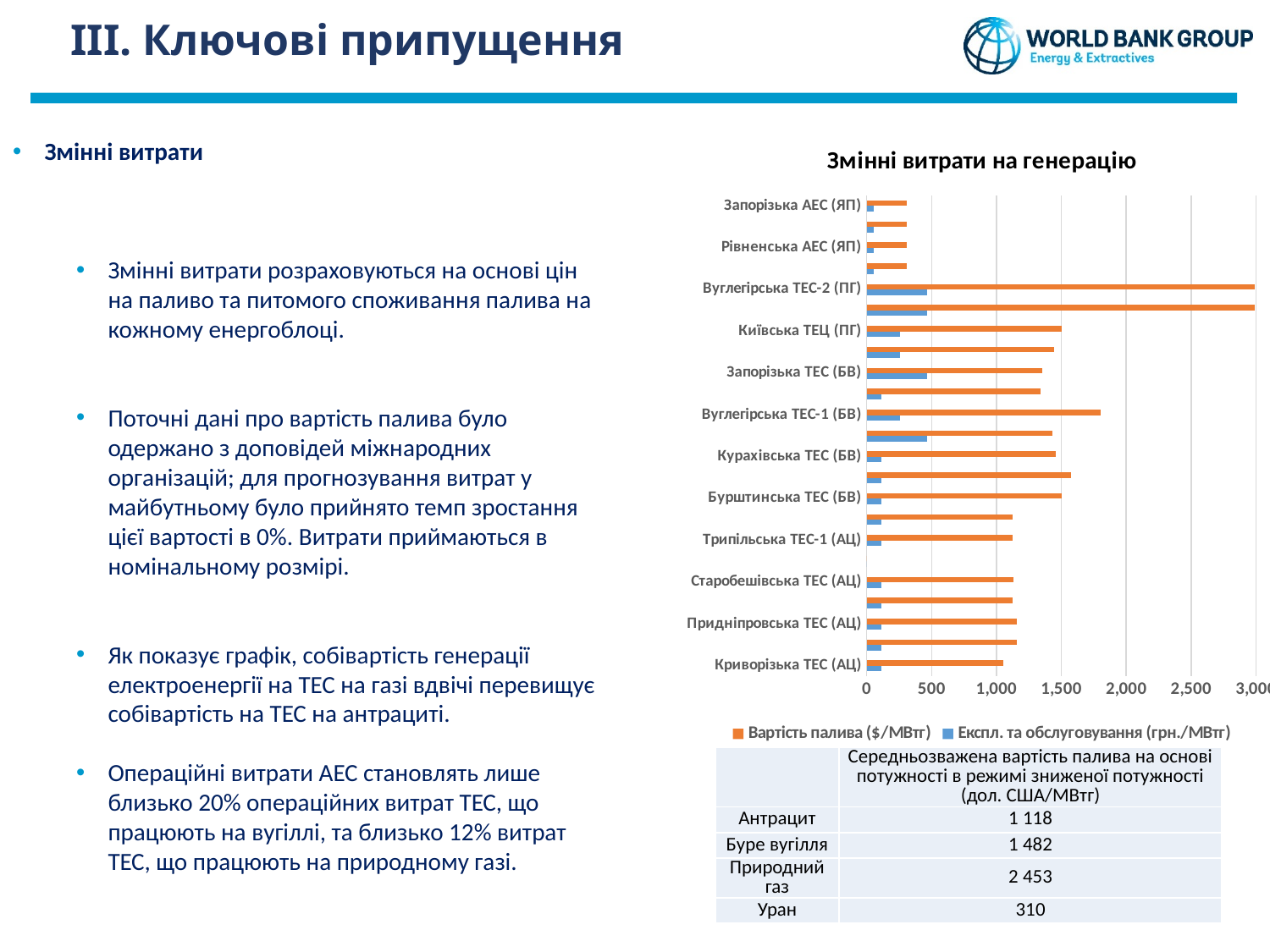
Is the fuel cost (Вартість палива) for Вуглегірська ТЕС-2 (ПГ) greater or less than 2,500? greater How many series does the legend of the chart list? 2 Is the fuel cost (Вартість палива) for Київська ТЕЦ (ПГ) greater or less than 1,000? greater Is the fuel cost (Вартість палива) for Криворізька ТЕС (АЦ) greater or less than 1,500? less Which series is shown in orange in the chart? Вартість палива ($/МВтг) What is the title of the chart? Змінні витрати на генерацію Which has the larger fuel cost (Вартість палива): Вуглегірська ТЕС-2 (ПГ) or Київська ТЕЦ (ПГ)? Вуглегірська ТЕС-2 (ПГ) Which has the larger operation and maintenance cost (Експл. та обслуговування): Вуглегірська ТЕС-2 (ПГ) or Криворізька ТЕС (АЦ)? Вуглегірська ТЕС-2 (ПГ) What kind of chart is shown on the slide? bar chart Which labeled plant has the highest fuel cost (Вартість палива) in the chart? Вуглегірська ТЕС-2 (ПГ)